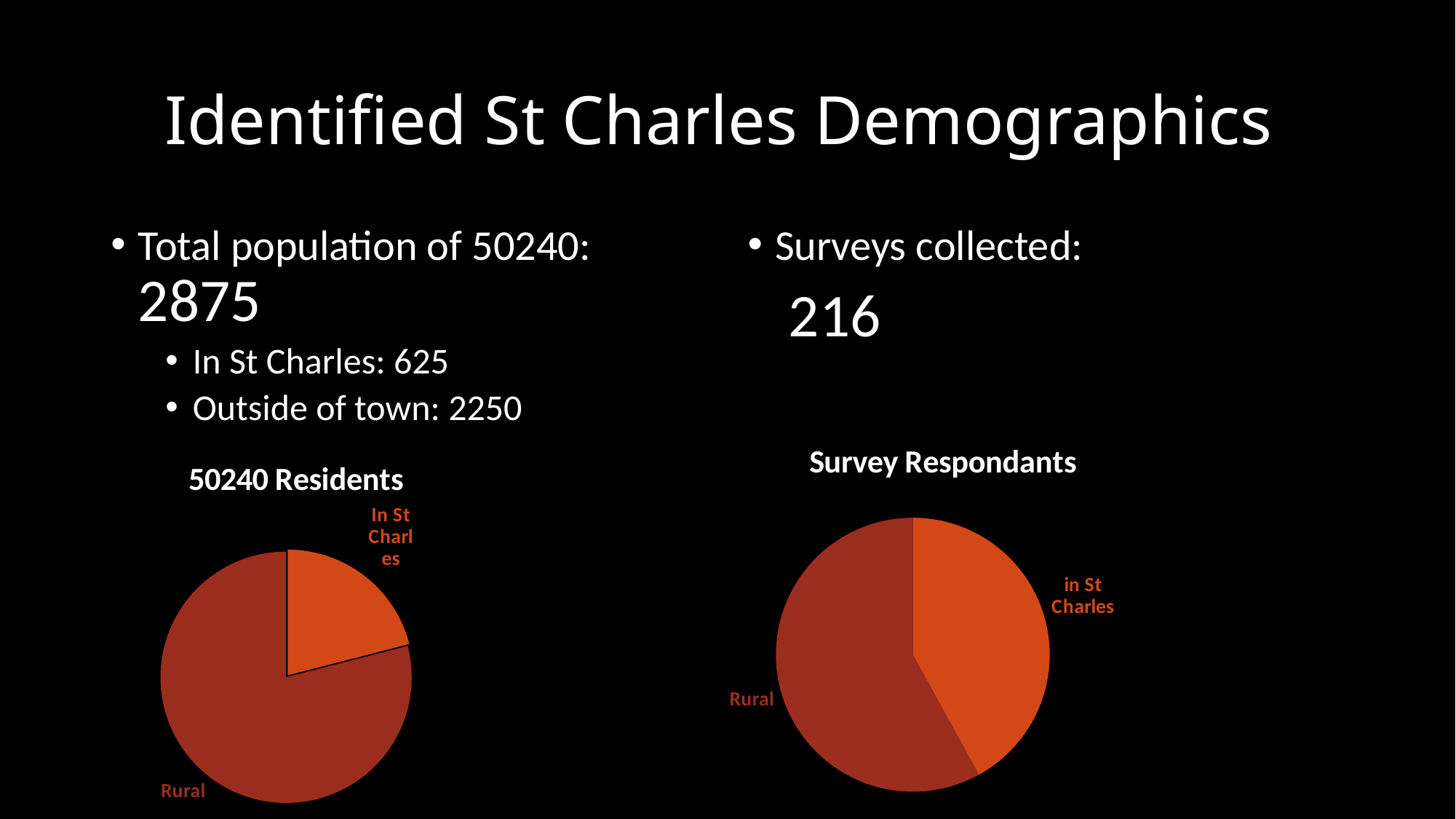
What is the title of the pie chart on the right side of the slide? Survey Respondants In the "50240 Residents" chart, which is larger: the Rural slice or the In St Charles slice? Rural What is the title of the pie chart on the left side of the slide? 50240 Residents In the "50240 Residents" chart, which slice is the largest? Rural In the "50240 Residents" chart, how many slices does the pie have? 2 What kind of chart is the "Survey Respondants" chart? pie chart In the "50240 Residents" chart, which slice is the smallest? In St Charles In the "Survey Respondants" chart, how many slices does the pie have? 2 In the "Survey Respondants" chart, which is larger: the in St Charles slice or the Rural slice? Rural What kind of chart is the "50240 Residents" chart? pie chart In the "Survey Respondants" chart, which slice is the smallest? in St Charles In the "Survey Respondants" chart, which slice is the largest? Rural